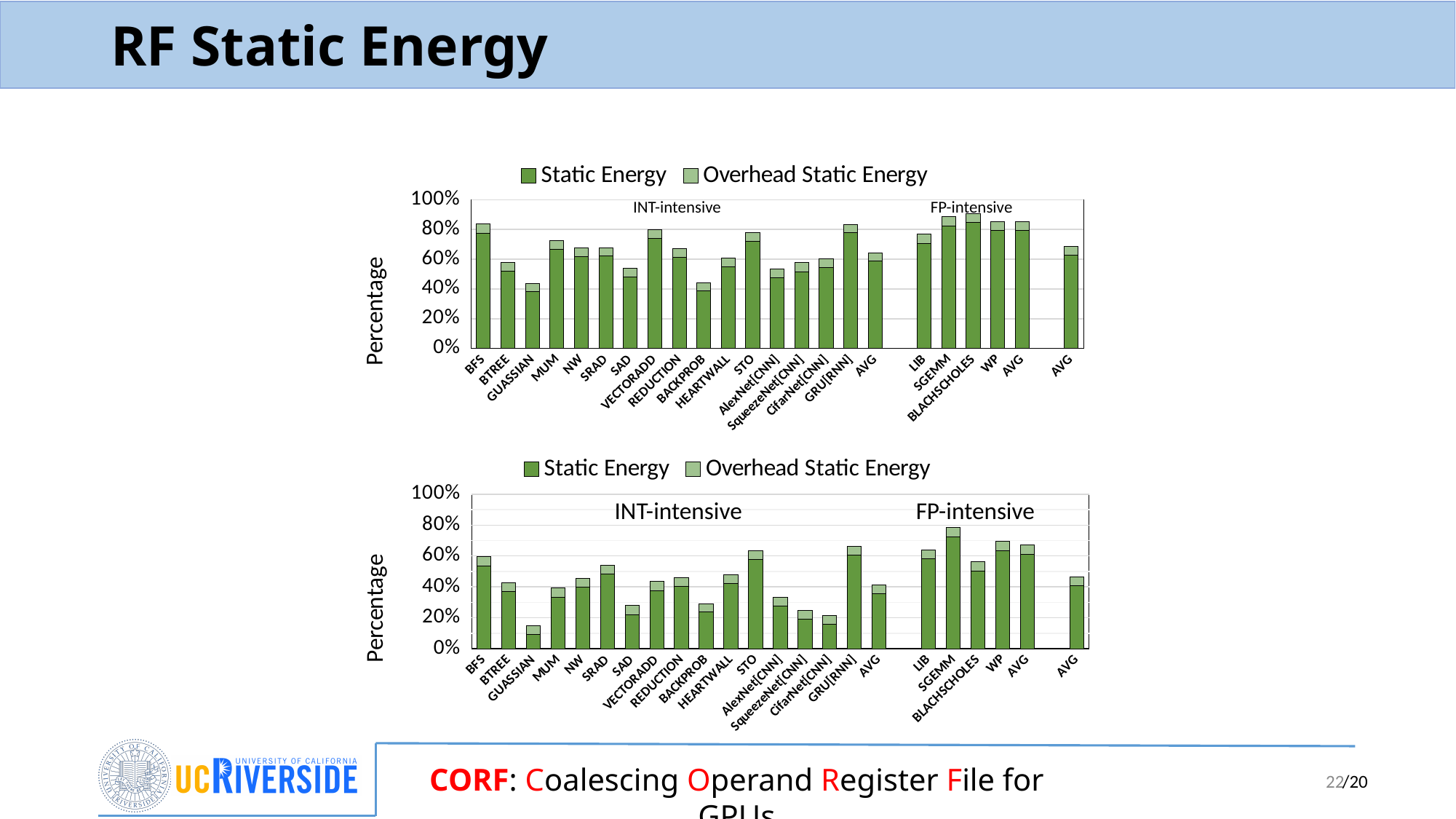
In the top chart, is the total value for BFS greater or less than 80%? greater In the bottom chart, which benchmark has the lowest total bar? GUASSIAN In the bottom chart, is the total value for GUASSIAN greater or less than 20%? less What type of chart is the top chart on the slide? Stacked bar chart In the bottom chart, which has the larger total bar, SGEMM or CifarNet[CNN]? SGEMM What are the two series named in the legend of the top chart? Static Energy and Overhead Static Energy In the bottom chart, is the total value for SGEMM greater or less than 60%? greater How many series does the legend of the bottom chart list? 2 In the bottom chart, which benchmark has the highest total bar? SGEMM What are the two benchmark group labels shown inside the bottom chart? INT-intensive and FP-intensive In the top chart, which benchmark has the highest total bar? BLACHSCHOLES